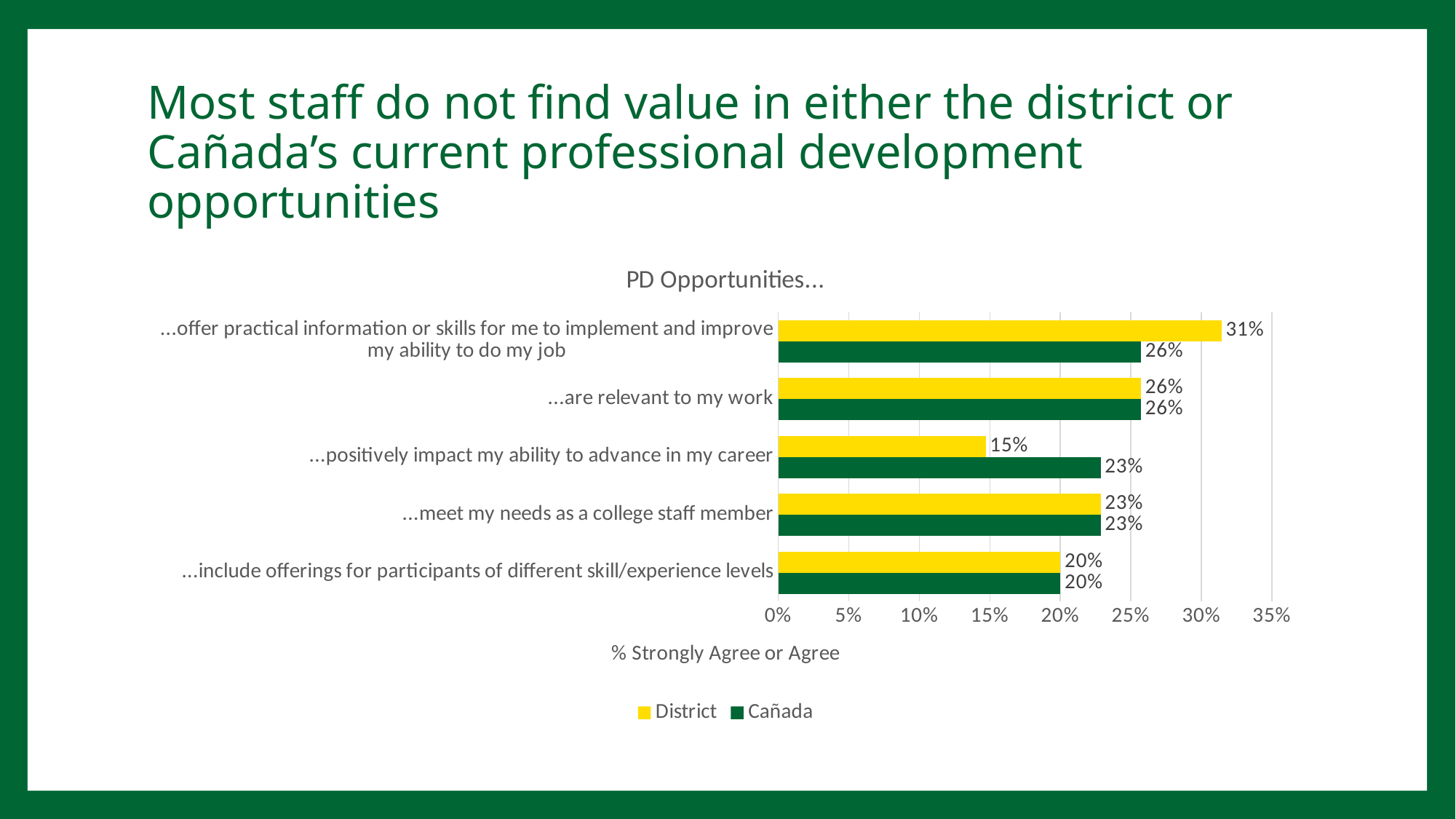
Is the District value for "...are relevant to my work" greater or less than 20%? greater What is the District value for "...include offerings for participants of different skill/experience levels"? 20% Which category has the highest District value? ...offer practical information or skills for me to implement and improve my ability to do my job What is the title of the chart? PD Opportunities... What is the difference between the District and Cañada values for "...positively impact my ability to advance in my career"? 8% How many categories are shown on the chart? 5 What is the District value for "...offer practical information or skills for me to implement and improve my ability to do my job"? 31% For "...offer practical information or skills for me to implement and improve my ability to do my job", which series has the larger value, District or Cañada? District What is the Cañada value for "...positively impact my ability to advance in my career"? 23% What kind of chart is shown on the slide? Bar chart How many series does the legend list? 2 Which category has the lowest District value? ...positively impact my ability to advance in my career